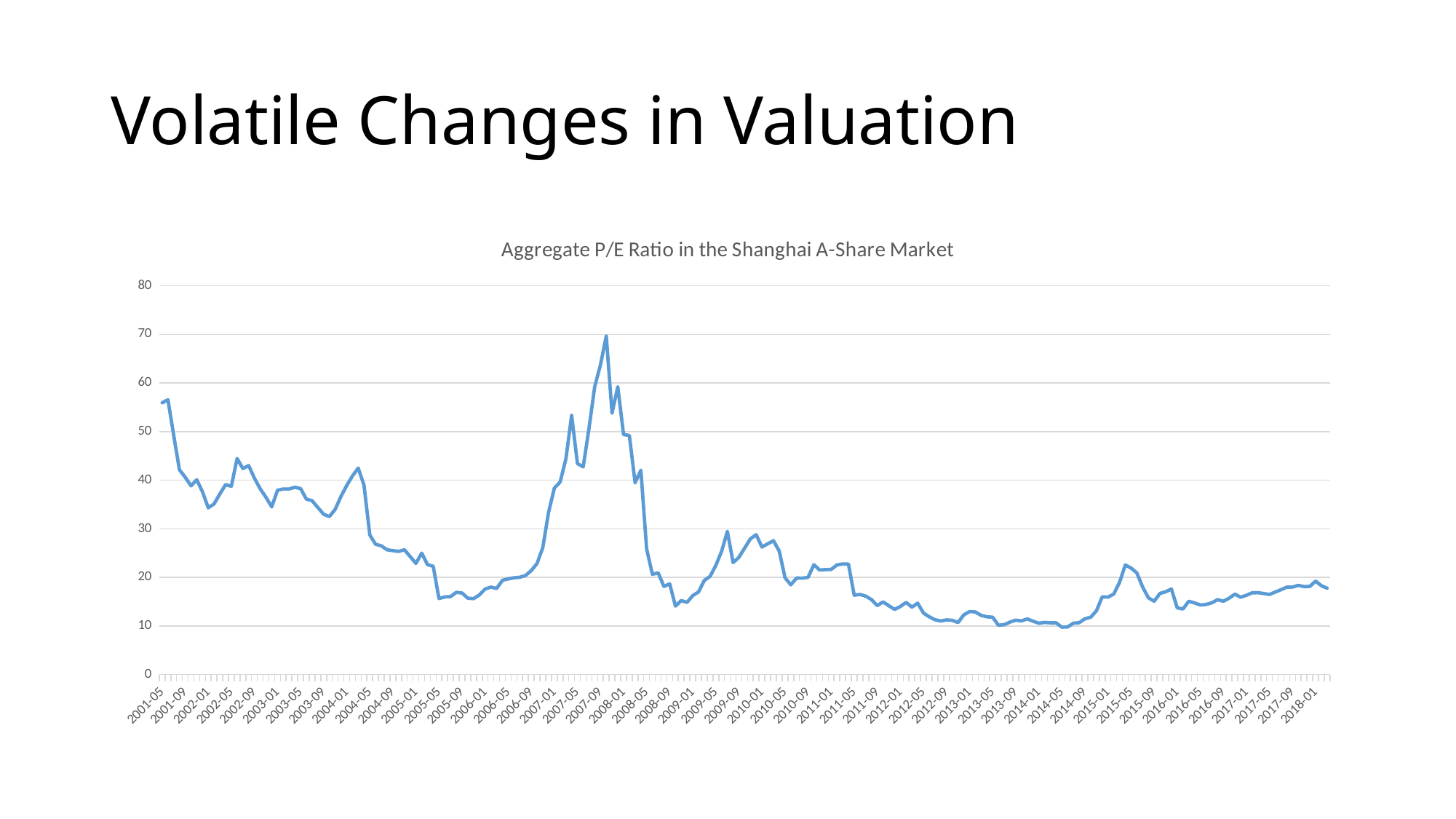
Does the line rise or fall from 2001-05 to 2005-09? fall Is the value at 2018-01 greater or less than 30? less Which is larger, the value at 2001-05 or the value at 2018-01? 2001-05 Is the value at 2001-05 greater or less than 50? greater Which is larger, the value at 2007-09 or the value at 2009-09? 2007-09 In which year does the line reach its highest value? 2007 Is the value at 2004-01 greater or less than 30? greater What is the title of the chart? Aggregate P/E Ratio in the Shanghai A-Share Market What kind of chart is shown on the slide? line chart